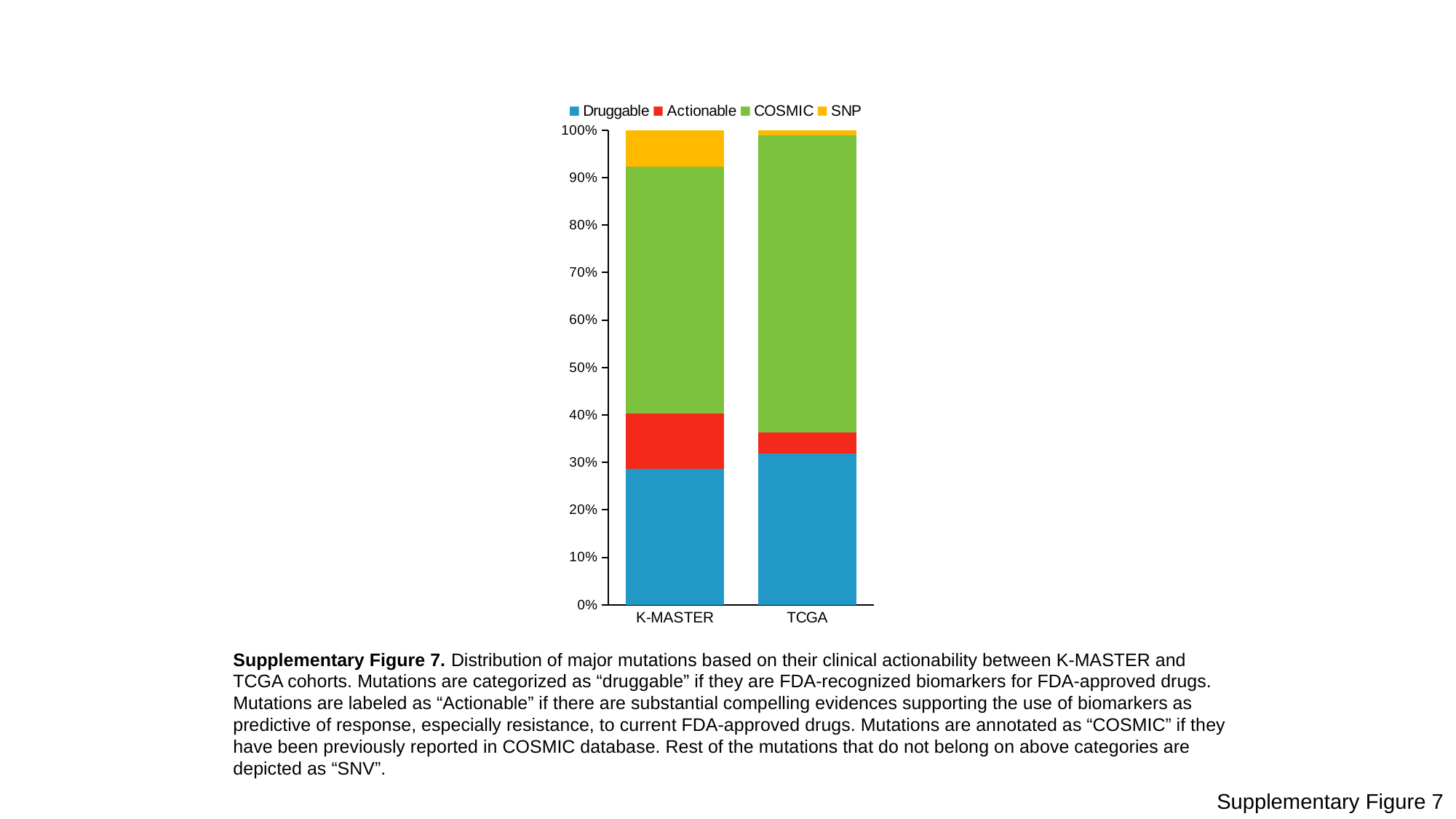
Is the Druggable share for K-MASTER greater or less than 20%? greater Is the SNP share for K-MASTER greater or less than 10%? less Which cohort has the larger COSMIC share, K-MASTER or TCGA? TCGA Which series is shown in yellow in the chart? SNP Is the COSMIC share for TCGA greater or less than 50%? greater Which series is shown in blue in the chart? Druggable Which cohort has the larger Actionable share, K-MASTER or TCGA? K-MASTER Which cohort has the larger SNP share, K-MASTER or TCGA? K-MASTER How many series does the chart legend list? 4 What kind of chart is shown on the slide? Stacked bar chart How many cohorts (categories) are shown on the x axis of the chart? 2